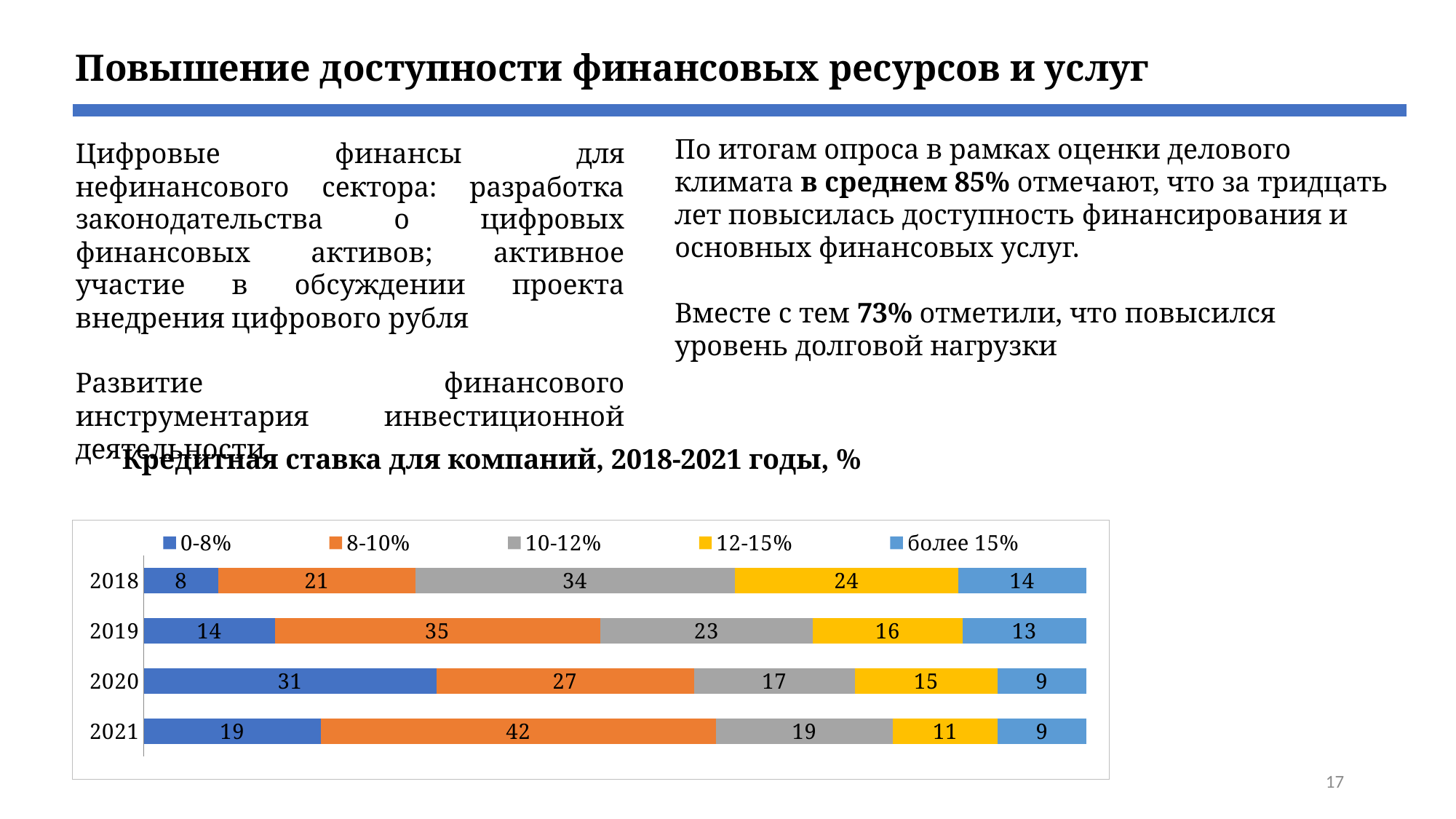
What is the value of the 8-10% series for 2021? 42 How many series does the legend list? 5 In which year is the 0-8% series highest? 2020 Which is larger: the 10-12% value for 2019 or the 10-12% value for 2020? 2019 What is the value of the 'более 15%' series for 2019? 13 In which year is the 12-15% series lowest? 2021 How many years (categories) are shown in the chart? 4 What is the title of the chart? Кредитная ставка для компаний, 2018-2021 годы, % What type of chart is shown on the slide? stacked bar chart What is the value of the 10-12% series for 2018? 34 What is the value of the 0-8% series for 2020? 31 What is the difference between the 8-10% values for 2021 and 2018? 21